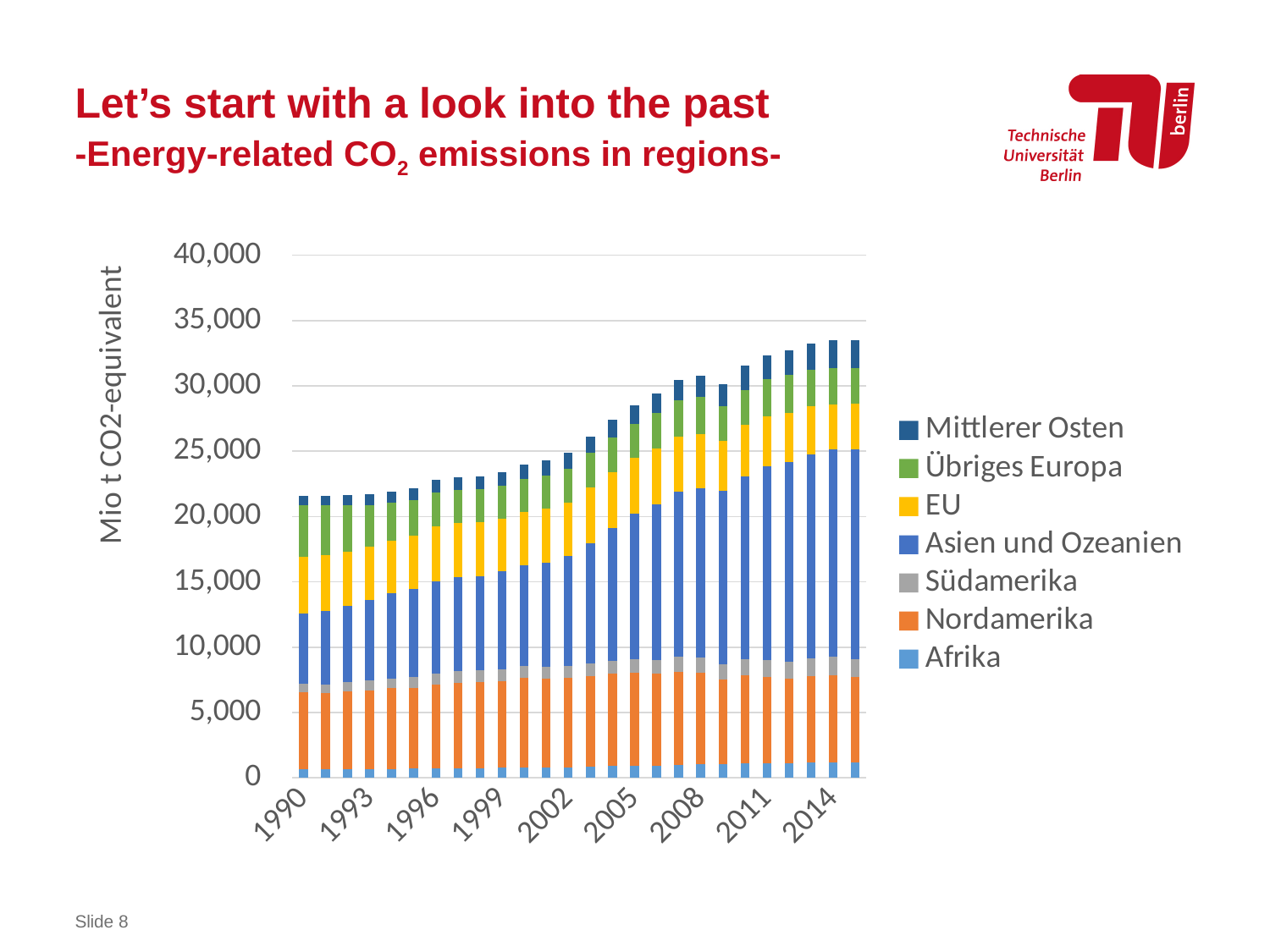
Is the total stacked value for 1990 greater or less than 25,000? less How many series does the legend list? 7 Which series forms the largest segment of the 2014 bar? Asien und Ozeanien Do the total emissions rise or fall from 1990 to 2014? rise What is the label on the vertical axis? Mio t CO2-equivalent Is the total stacked value for 2014 greater or less than 30,000? greater Which is larger, the total stacked value for 2008 or for 1990? 2008 Is the total stacked value for 2005 greater or less than 25,000? greater Which series forms the largest segment of the 1990 bar? Nordamerika What kind of chart is shown on the slide? stacked bar chart Which series is shown in yellow? EU